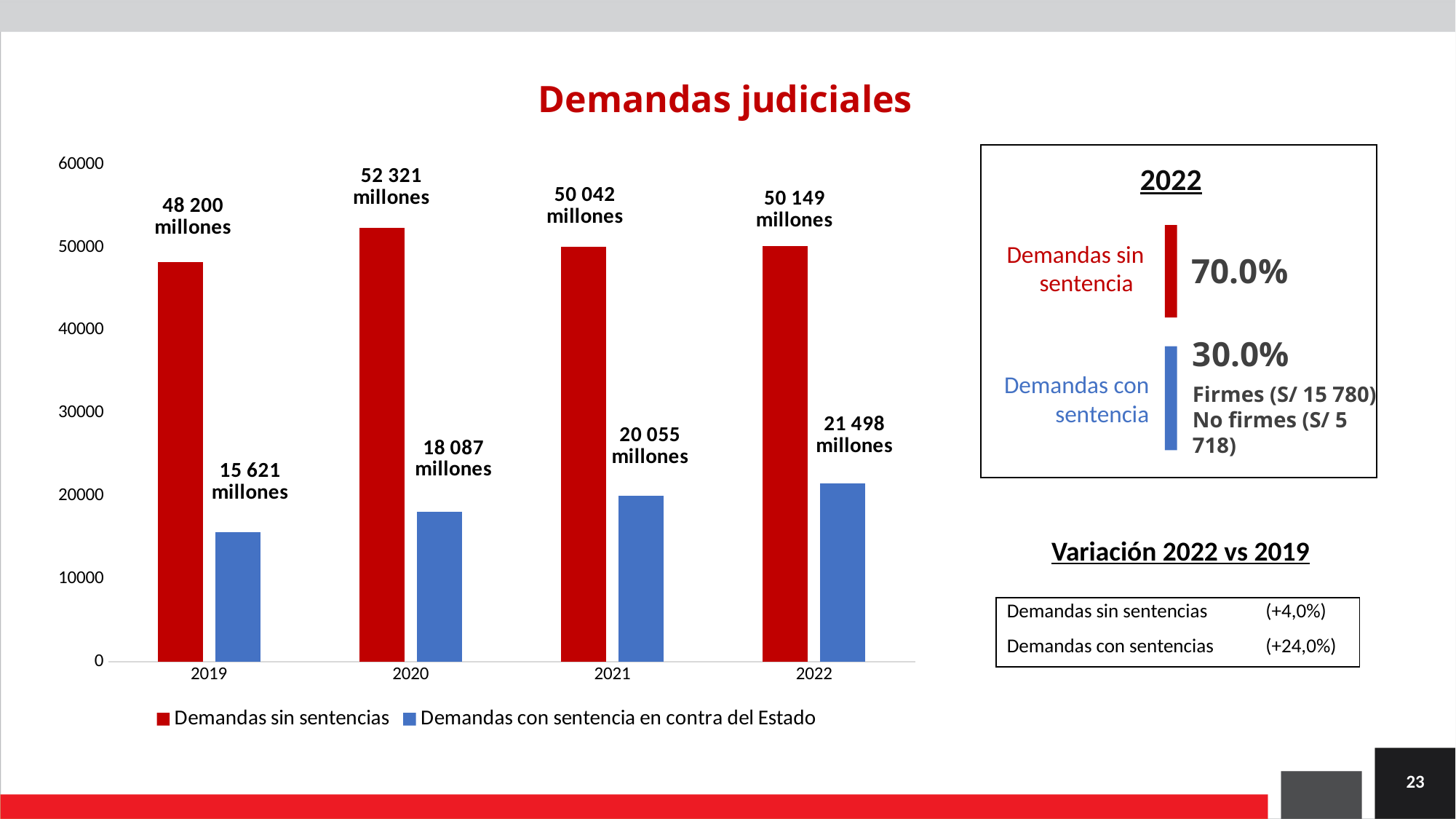
In which year is Demandas sin sentencias highest? 2020 What is the difference between Demandas sin sentencias and Demandas con sentencia en contra del Estado in 2021? 29 987 millones What kind of chart is shown on the slide? bar chart How many series does the chart legend list? 2 Is the value for Demandas sin sentencias in 2019 greater or less than 40000? greater How many years are shown on the x axis of the chart? 4 Does Demandas con sentencia en contra del Estado rise or fall from 2019 to 2022? rise What is the value for Demandas con sentencia en contra del Estado in 2019? 15 621 millones What is the value for Demandas con sentencia en contra del Estado in 2022? 21 498 millones What is the value for Demandas sin sentencias in 2020? 52 321 millones Which is larger: Demandas con sentencia en contra del Estado in 2020 or in 2021? 2021 In which year is Demandas con sentencia en contra del Estado lowest? 2019